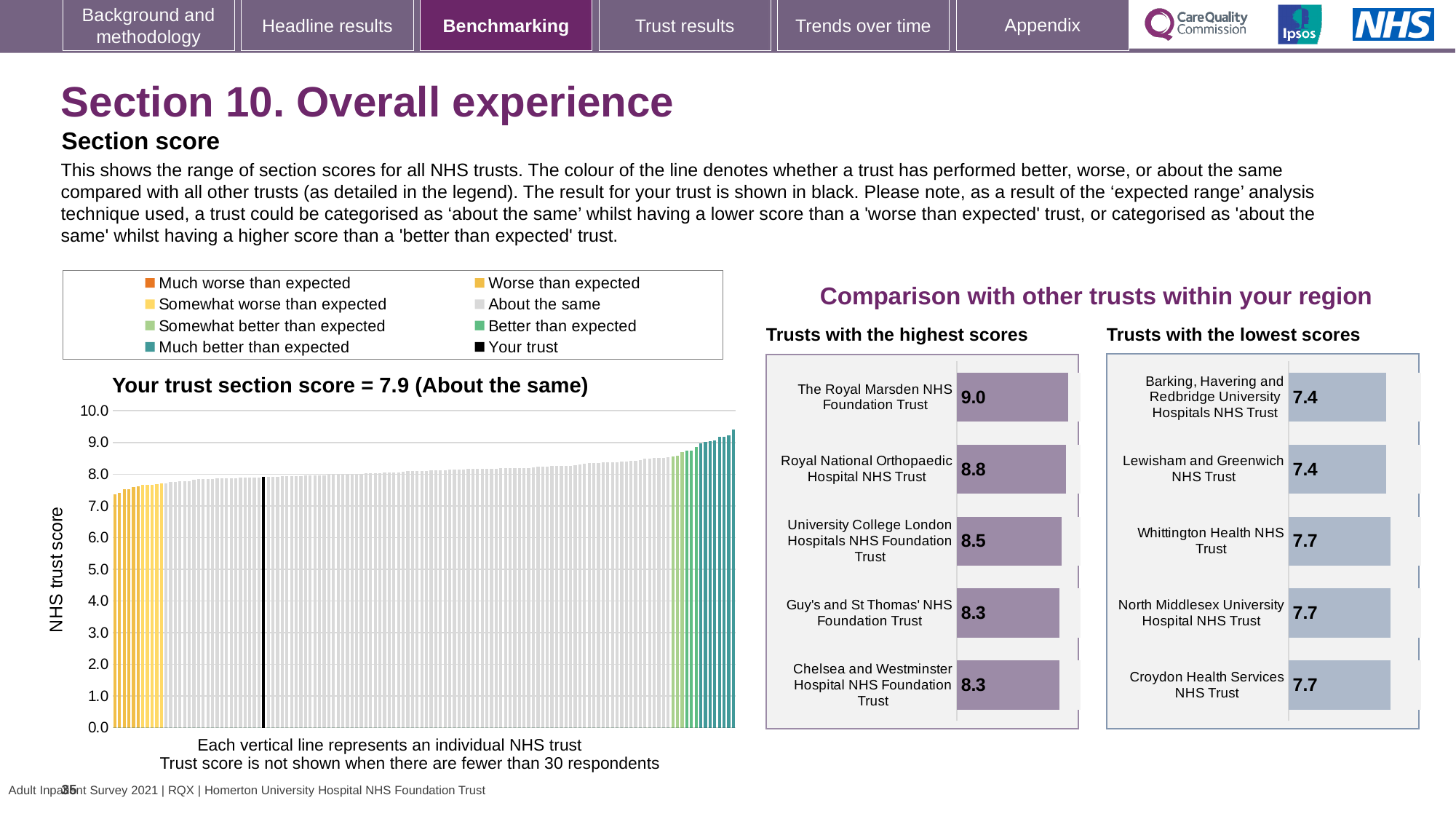
In the chart 'Your trust section score', what is the section score for your trust? 7.9 In the 'Your trust section score' chart, is the value of the leftmost (lowest) bar greater or less than 7.0? greater In the 'Trusts with the highest scores' chart, what is the score for The Royal Marsden NHS Foundation Trust? 9.0 In the 'Trusts with the lowest scores' chart, which has the larger score: Whittington Health NHS Trust or Barking, Havering and Redbridge University Hospitals NHS Trust? Whittington Health NHS Trust In the 'Your trust section score' chart, do the trust scores rise or fall from left to right along the x axis? rise In the 'Trusts with the lowest scores' chart, what is the score for Lewisham and Greenwich NHS Trust? 7.4 How many entries does the legend above the 'Your trust section score' chart list? 8 In the 'Your trust section score' chart, what is the label of the y axis? NHS trust score How many trusts are shown in the 'Trusts with the highest scores' chart? 5 In the 'Trusts with the highest scores' chart, which trust has the highest score? The Royal Marsden NHS Foundation Trust In the 'Trusts with the highest scores' chart, what is the difference between the scores of The Royal Marsden NHS Foundation Trust and Royal National Orthopaedic Hospital NHS Trust? 0.2 What kind of chart is the 'Your trust section score' chart? bar chart